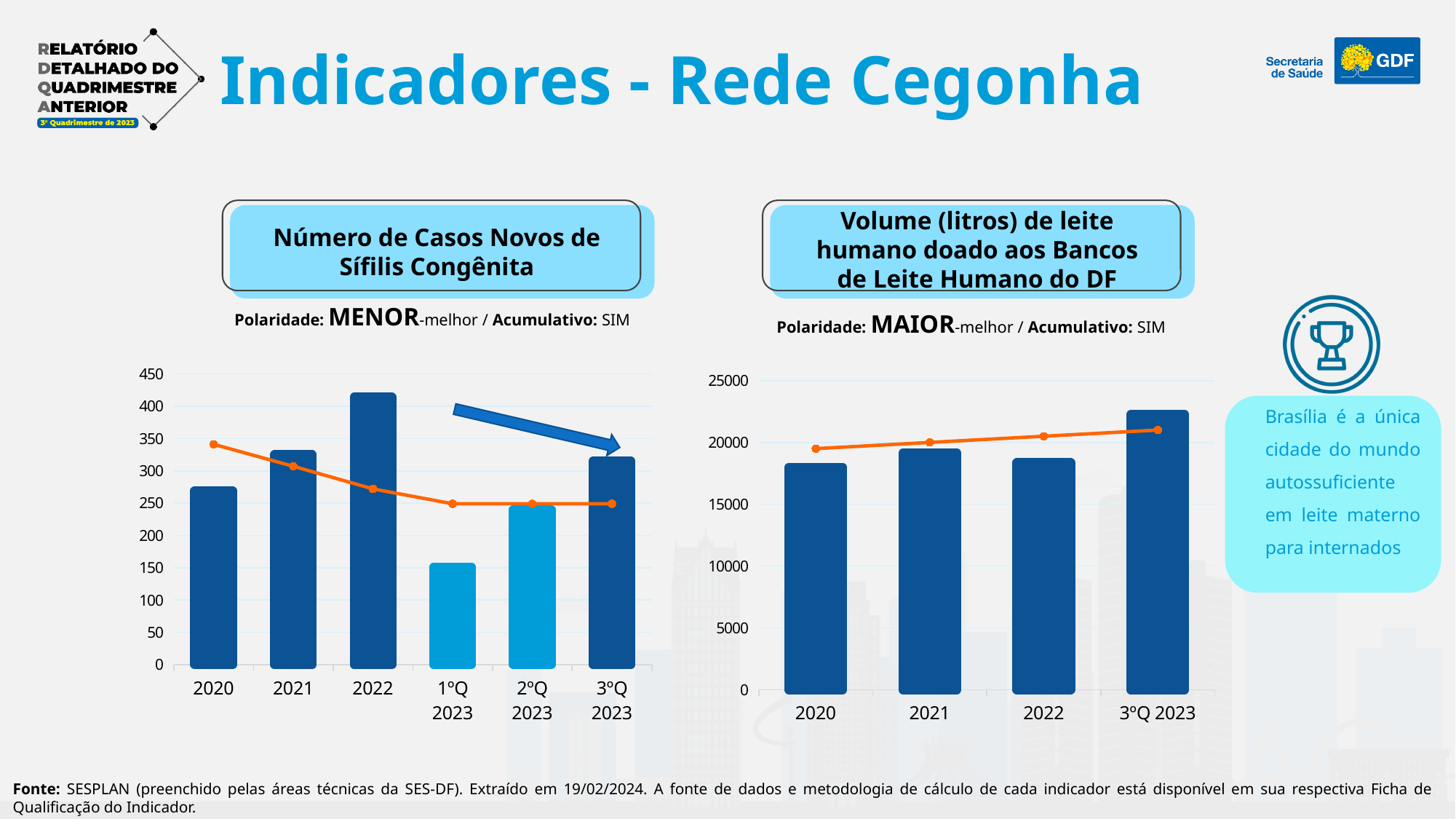
In the chart 'Número de Casos Novos de Sífilis Congênita', which bar is taller, 2020 or 2021? 2021 In the chart 'Volume (litros) de leite humano doado aos Bancos de Leite Humano do DF', is the bar for 3ºQ 2023 greater or less than 20000? greater In the chart 'Número de Casos Novos de Sífilis Congênita', is the bar for 1ºQ 2023 greater or less than 200? less How many categories are shown on the x axis of the chart 'Número de Casos Novos de Sífilis Congênita'? 6 In the chart 'Número de Casos Novos de Sífilis Congênita', which category has the tallest bar? 2022 How many categories are shown on the x axis of the chart 'Volume (litros) de leite humano doado aos Bancos de Leite Humano do DF'? 4 In the chart 'Volume (litros) de leite humano doado aos Bancos de Leite Humano do DF', which category has the tallest bar? 3ºQ 2023 In the chart 'Número de Casos Novos de Sífilis Congênita', is the bar for 2022 greater or less than 400? greater In the chart 'Volume (litros) de leite humano doado aos Bancos de Leite Humano do DF', does the orange line rise or fall from 2020 to 3ºQ 2023? rises In the chart 'Número de Casos Novos de Sífilis Congênita', which category has the shortest bar? 1ºQ 2023 What kind of chart is 'Volume (litros) de leite humano doado aos Bancos de Leite Humano do DF'? bar chart with a line